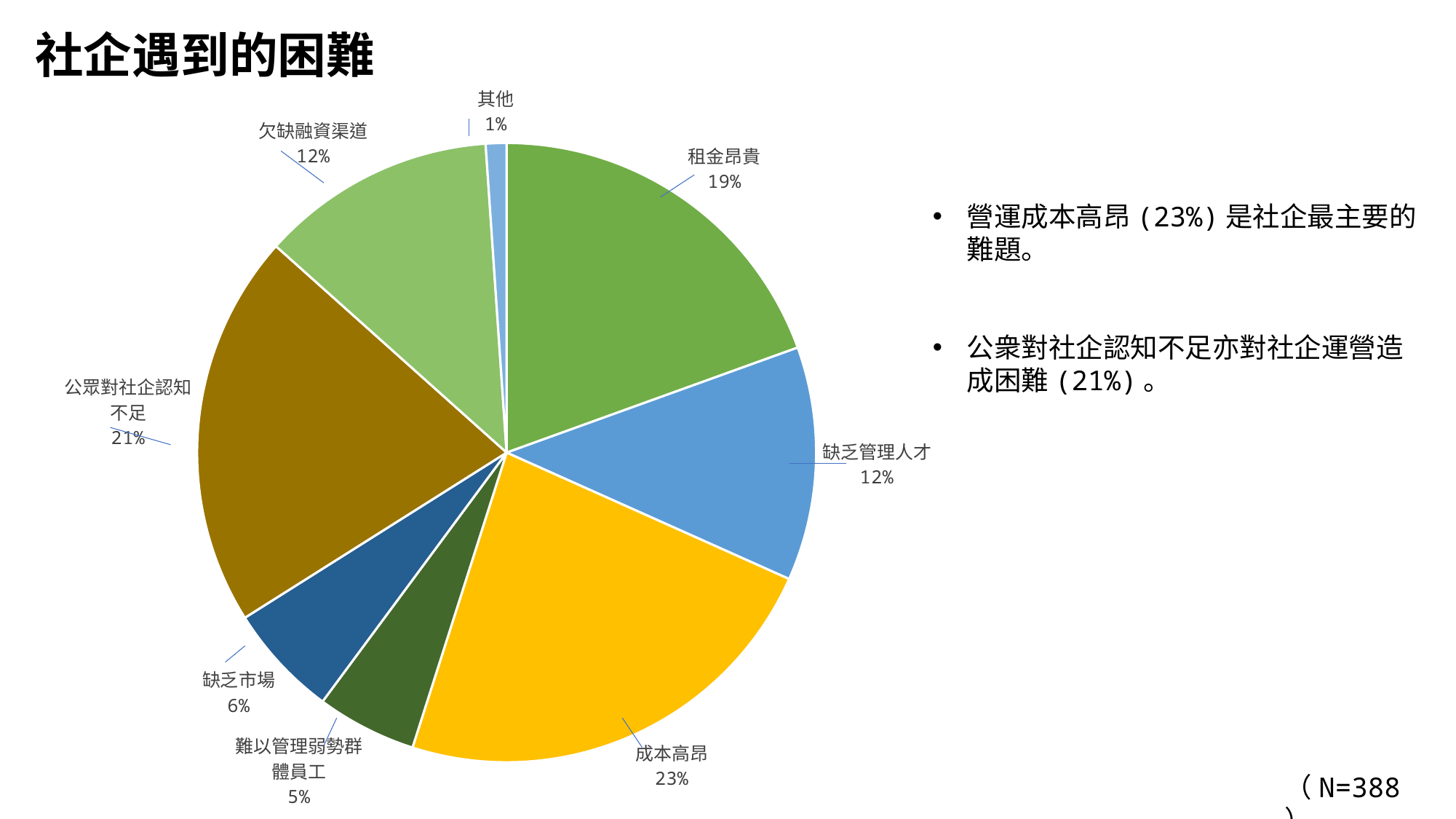
What share of the pie does 成本高昂 account for? 23% What is the difference in percentage points between 公眾對社企認知不足 and 欠缺融資渠道? 9 What is the value shown for 缺乏市場? 6% Which category has the largest slice of the pie? 成本高昂 Which is larger, 缺乏市場 or 難以管理弱勢群體員工? 缺乏市場 Which category has the smallest slice of the pie? 其他 How many slices does the pie chart have? 8 What is the difference in percentage points between 成本高昂 and 租金昂貴? 4 What is the value shown for 公眾對社企認知不足? 21% What kind of chart is shown on the slide? pie chart What is the value shown for 租金昂貴? 19% What is the title of the slide containing the pie chart? 社企遇到的困難